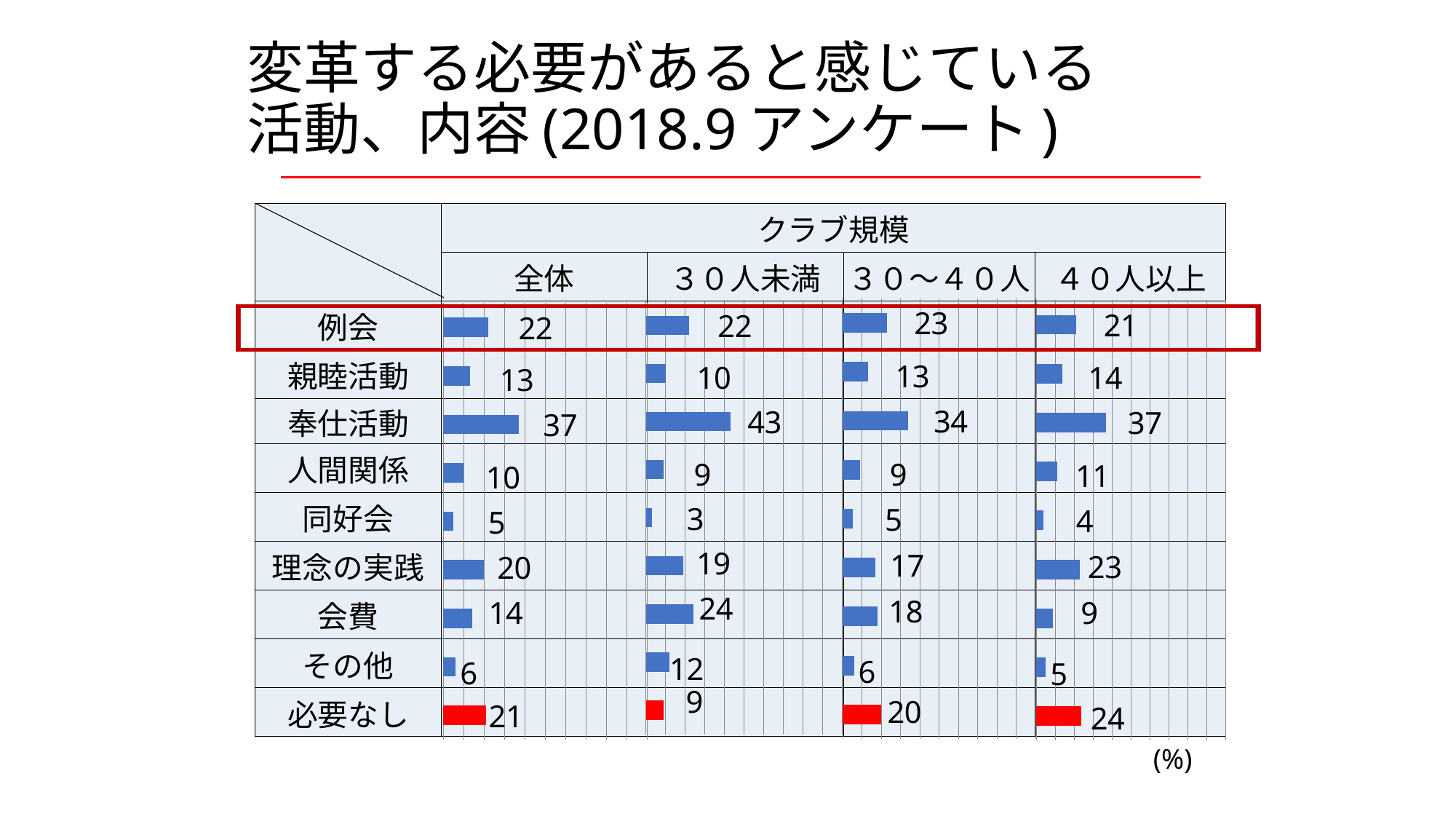
In the ３０人未満 column, which category has the lowest value? 同好会 What is the difference between the 奉仕活動 values for ３０人未満 and ３０〜４０人? 9 In the ４０人以上 column, what is the value for 必要なし? 24 How many activity categories are listed in the table? 9 In the ３０人未満 column, what is the value for 会費? 24 Which row's bars are coloured red instead of blue? 必要なし Which is larger: the 会費 value for ３０人未満 or for ４０人以上? ３０人未満 In the 全体 column, what is the value for 奉仕活動? 37 In the ３０〜４０人 column, what is the value for 例会? 23 How many club-size columns (including 全体) are shown? 4 In the 全体 column, which category has the highest value? 奉仕活動 What kind of chart is used inside the table cells? bar chart